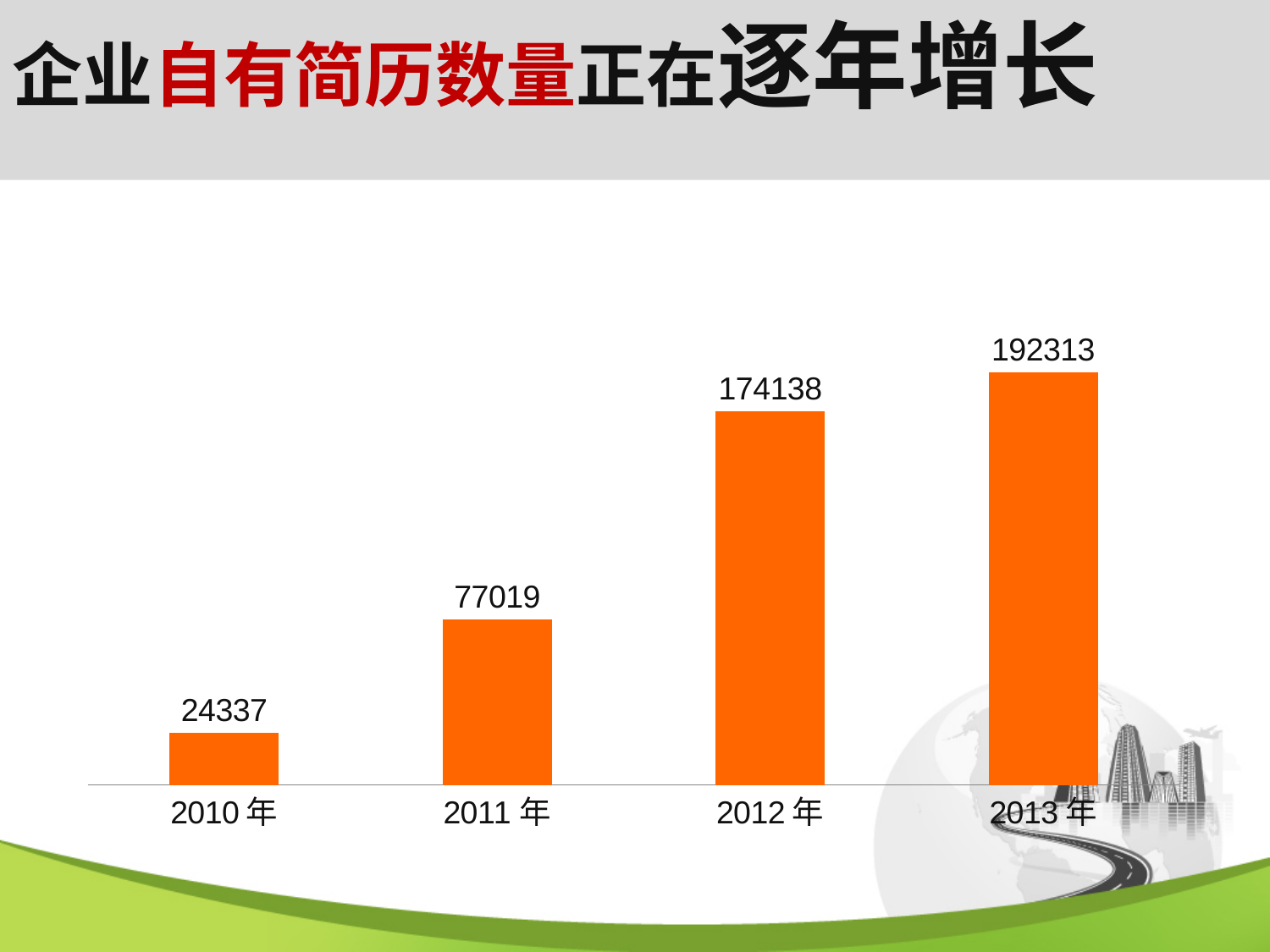
How many years are shown on the chart? 4 Which year has the highest value? 2013年 What is the value for 2013年? 192313 What is the value for 2010年? 24337 What kind of chart is shown on the slide? Bar chart Which year has the lowest value? 2010年 What is the value for 2012年? 174138 What is the difference between the values for 2013年 and 2012年? 18175 Which is larger, the value for 2011年 or the value for 2012年? 2012年 Do the values rise or fall from 2010年 to 2013年? Rise What is the difference between the values for 2011年 and 2010年? 52682 What is the value for 2011年? 77019